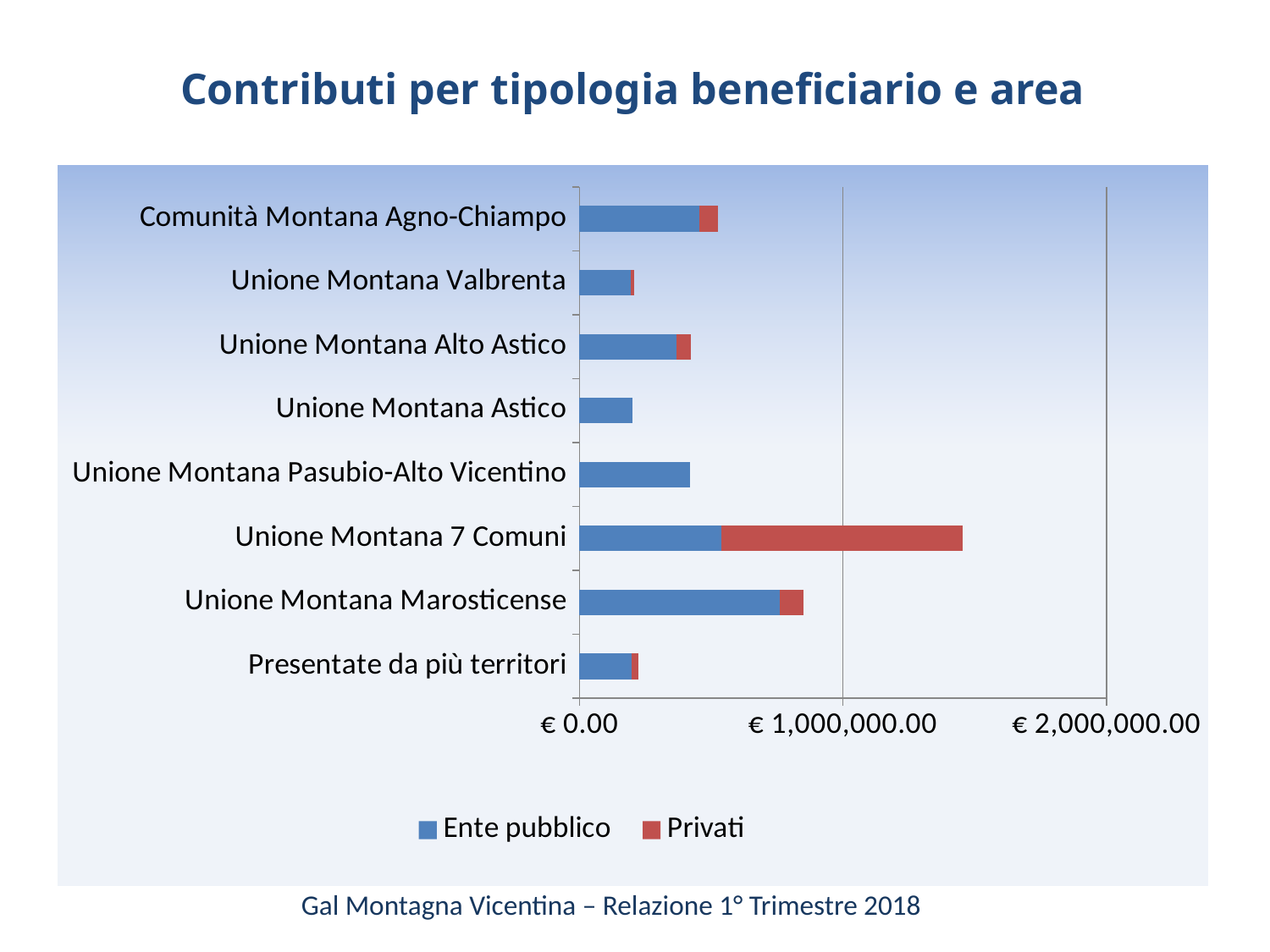
Which area has the highest total contribution? Unione Montana 7 Comuni Is the total value for Unione Montana Marosticense greater or less than € 1,000,000.00? less Which has a larger total contribution, Unione Montana Marosticense or Comunità Montana Agno-Chiampo? Unione Montana Marosticense What is the title of the chart? Contributi per tipologia beneficiario e area Is the total value for Unione Montana 7 Comuni greater or less than € 1,000,000.00? greater Is the total value for Comunità Montana Agno-Chiampo greater or less than € 1,000,000.00? less Which area has the largest Privati contribution? Unione Montana 7 Comuni How many categories (areas) are plotted on the chart? 8 Which colour represents the Privati series in the legend? Red Which has a larger Ente pubblico contribution, Unione Montana Marosticense or Unione Montana 7 Comuni? Unione Montana Marosticense How many series does the legend list? 2 What kind of chart is shown on the slide? Stacked bar chart